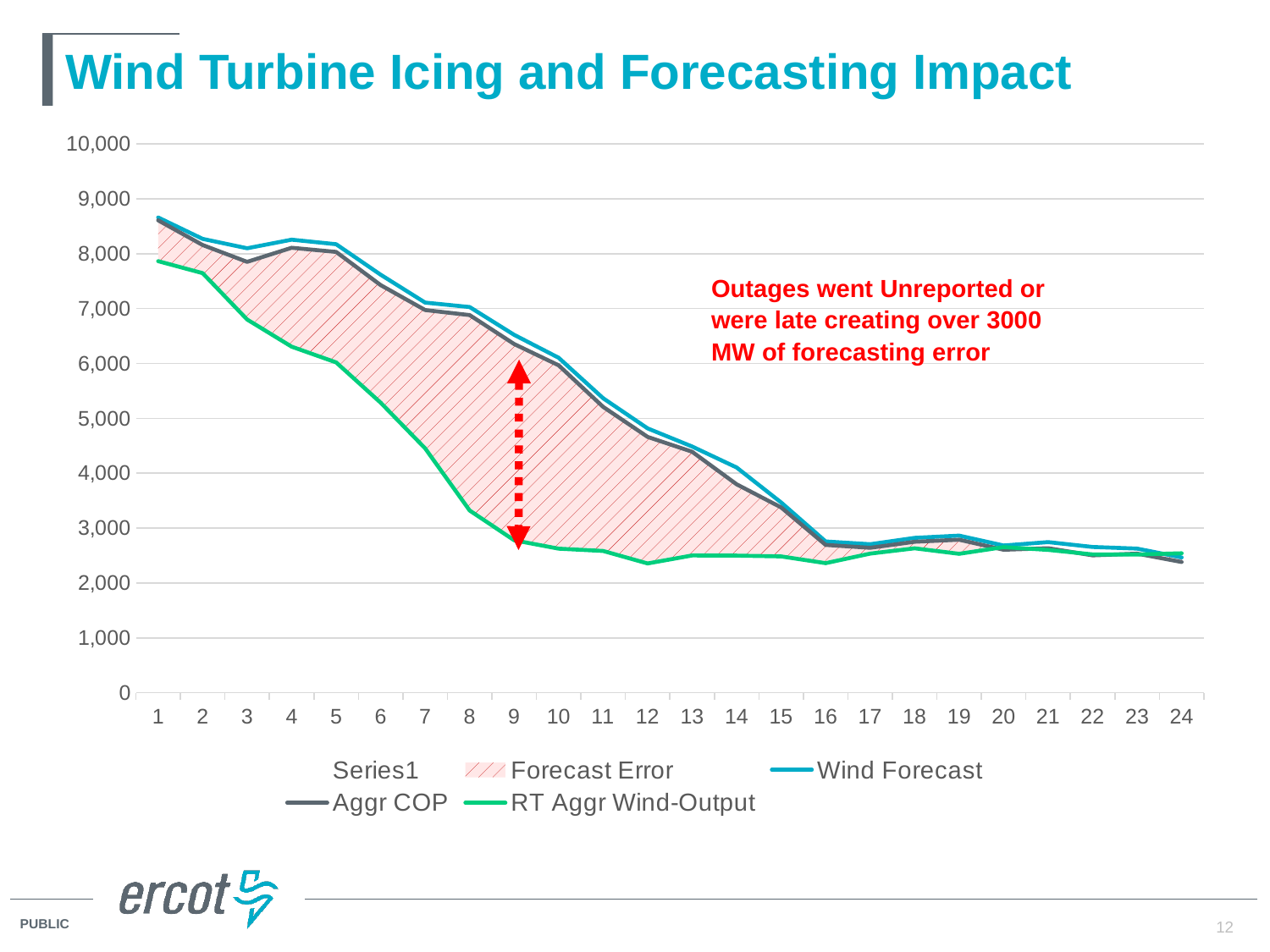
Is the Wind Forecast value at hour 1 greater or less than 8,000? greater At which hour is the Wind Forecast value highest? 1 Is the Aggr COP value at hour 24 greater or less than 3,000? less Is the RT Aggr Wind-Output value at hour 9 greater or less than 3,000? less What kind of chart is shown on the slide? Line chart At hour 9, which is larger: Wind Forecast or RT Aggr Wind-Output? Wind Forecast Does the RT Aggr Wind-Output line rise or fall from hour 1 to hour 24? Fall According to the annotation on the chart, how much forecasting error did the unreported or late outages create? Over 3000 MW What is the title of the chart on the slide? Wind Turbine Icing and Forecasting Impact How many entries does the chart's legend list? 5 How many points are plotted along the x axis? 24